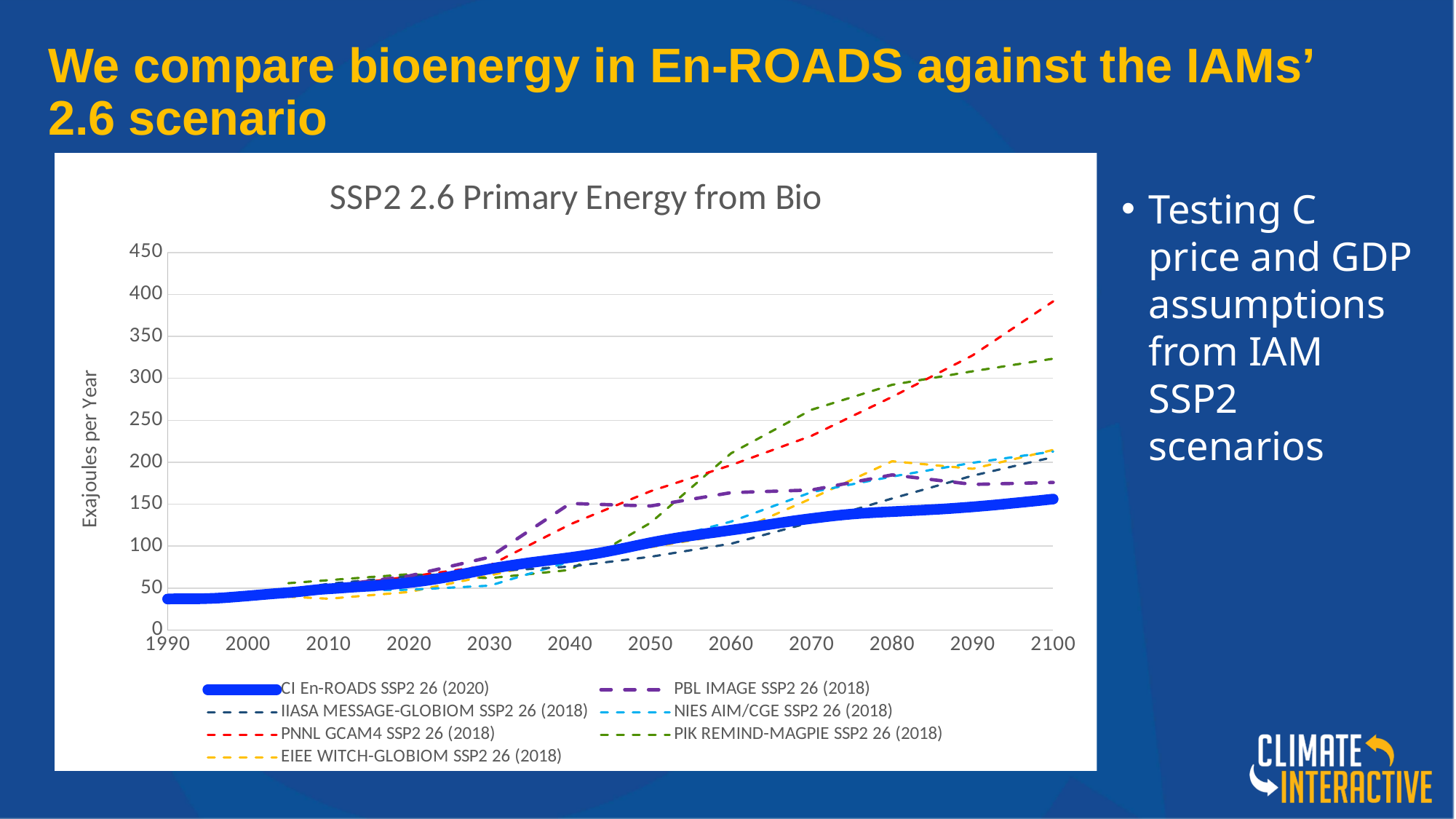
Which series has the highest value in 2100? PNNL GCAM4 SSP2 26 (2018) What is the label on the vertical axis of the chart? Exajoules per Year Is the value for PNNL GCAM4 SSP2 26 (2018) in 2100 greater or less than 350? greater What is the title of the chart? SSP2 2.6 Primary Energy from Bio In 2100, which is larger: PNNL GCAM4 SSP2 26 (2018) or PIK REMIND-MAGPIE SSP2 26 (2018)? PNNL GCAM4 SSP2 26 (2018) Is the value for CI En-ROADS SSP2 26 (2020) in 1990 greater or less than 50? less How many series does the legend list? 7 Which series has the lowest value in 2100? CI En-ROADS SSP2 26 (2020) Is the value for PBL IMAGE SSP2 26 (2018) in 2100 greater or less than 200? less What kind of chart is shown on the slide? line chart Does the CI En-ROADS SSP2 26 (2020) series rise or fall from 1990 to 2100? rise